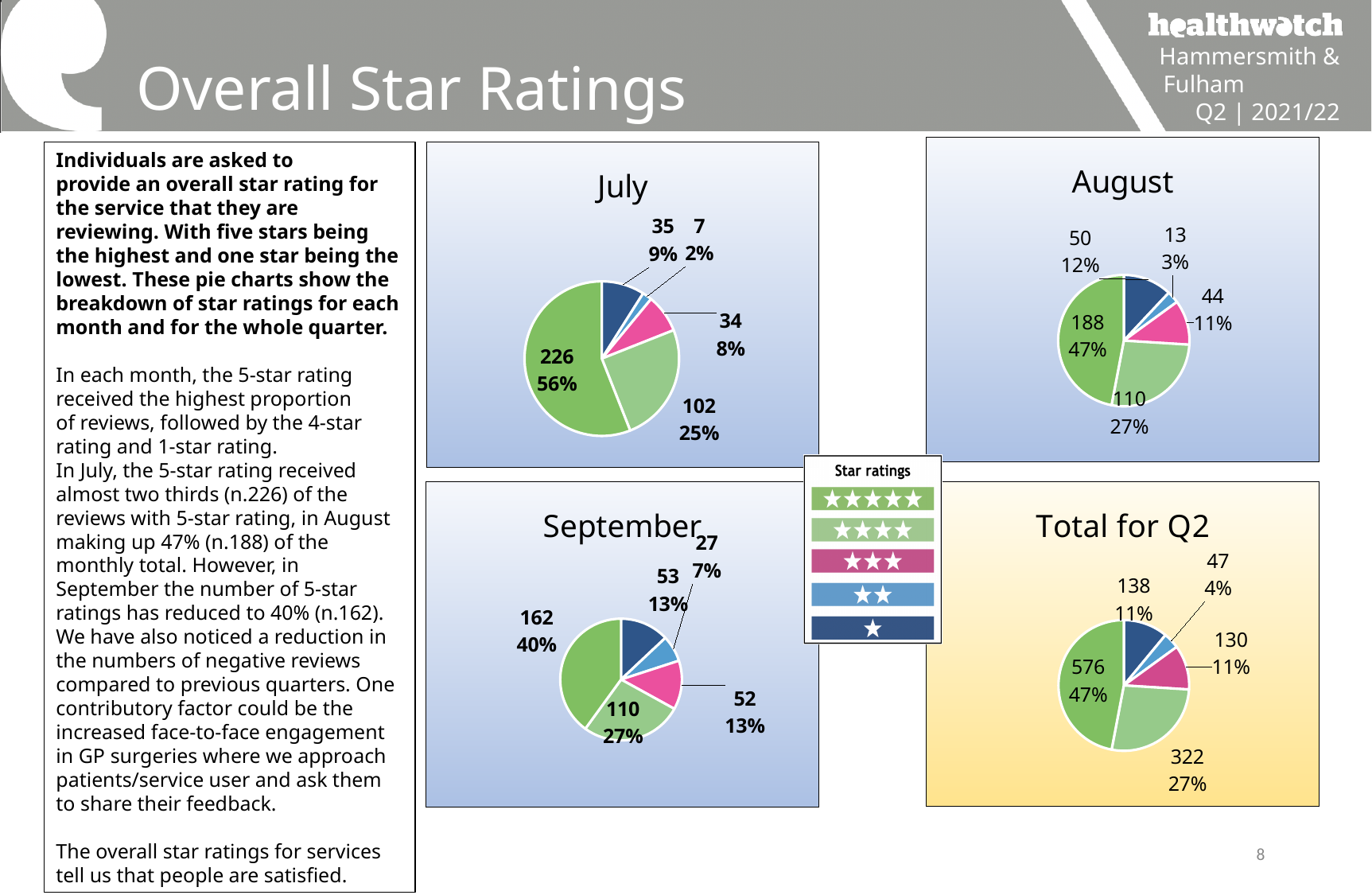
In the Total for Q2 chart, which is larger: the number of 1-star reviews or the number of 3-star reviews? 1-star reviews (138) What kind of charts are shown on the slide? Pie charts In the Total for Q2 chart, which star rating has the largest slice? 5 stars In the August chart, how many reviews gave a 3-star rating? 44 In the September chart, what percentage of reviews gave a 5-star rating? 40% In the July chart, how many reviews gave a 5-star rating? 226 In the Total for Q2 chart, how many reviews gave a 4-star rating? 322 In the July chart, what percentage of reviews gave a 4-star rating? 25% In the September chart, what is the difference between the number of 5-star and 4-star reviews? 52 How many star rating categories does the legend list? 5 How many pie charts are on the slide? 4 In the August chart, which star rating has the smallest slice? 2 stars